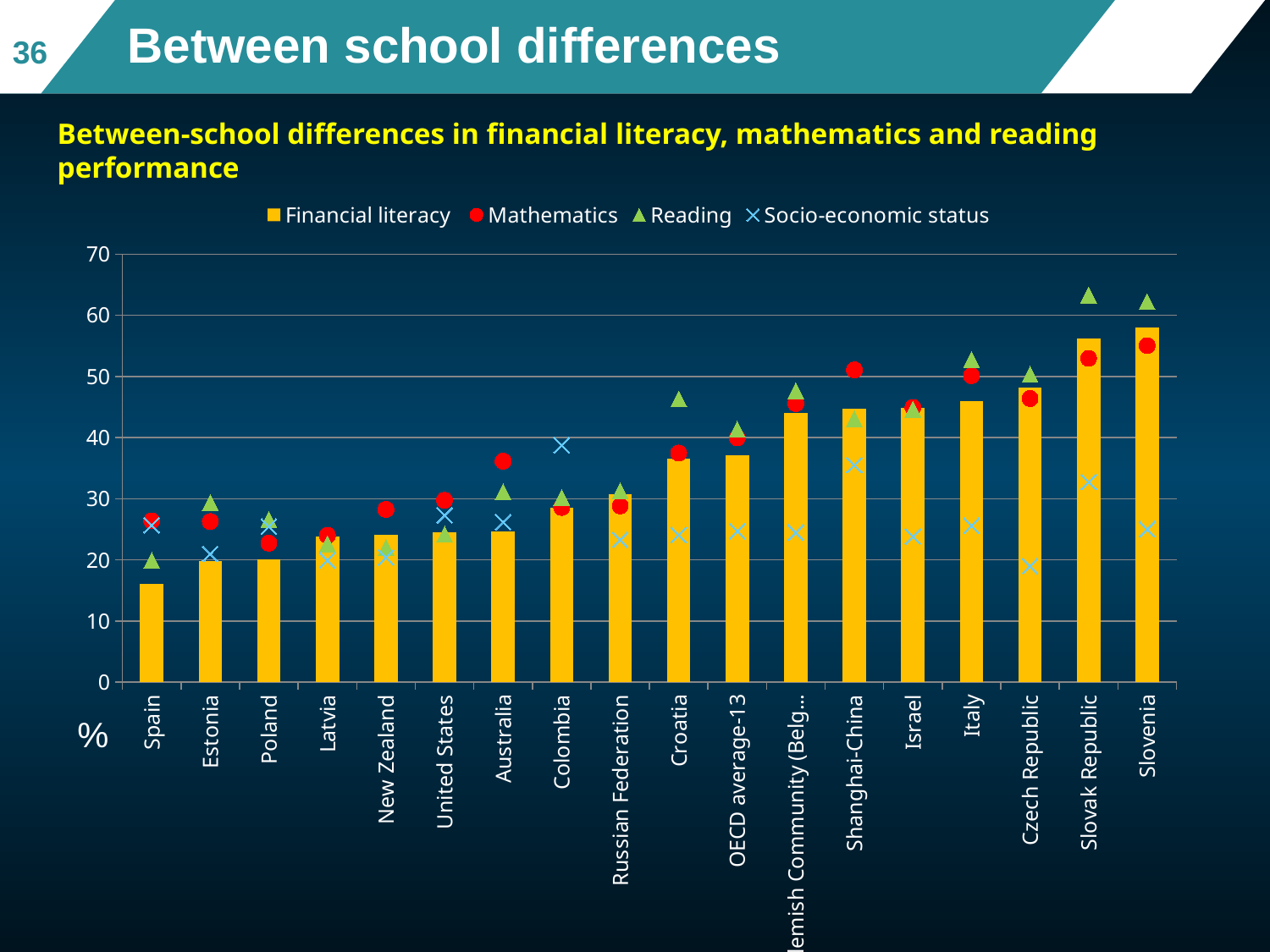
Do the Financial literacy bars rise or fall from left to right along the x axis? Rise Is the Financial literacy value for Slovenia greater or less than 50? greater Which country has the highest Financial literacy bar? Slovenia Is the Reading value for the Slovak Republic greater or less than 60? greater Is the Socio-economic status value for Colombia greater or less than 30? greater How many series does the legend list? 4 How many countries/economies are shown along the x axis? 18 Which legend series is shown with an X marker? Socio-economic status What kind of chart is shown on the slide? Bar chart (with overlaid markers) Which country has the lowest Financial literacy bar? Spain Which has the larger Financial literacy value, Croatia or Estonia? Croatia